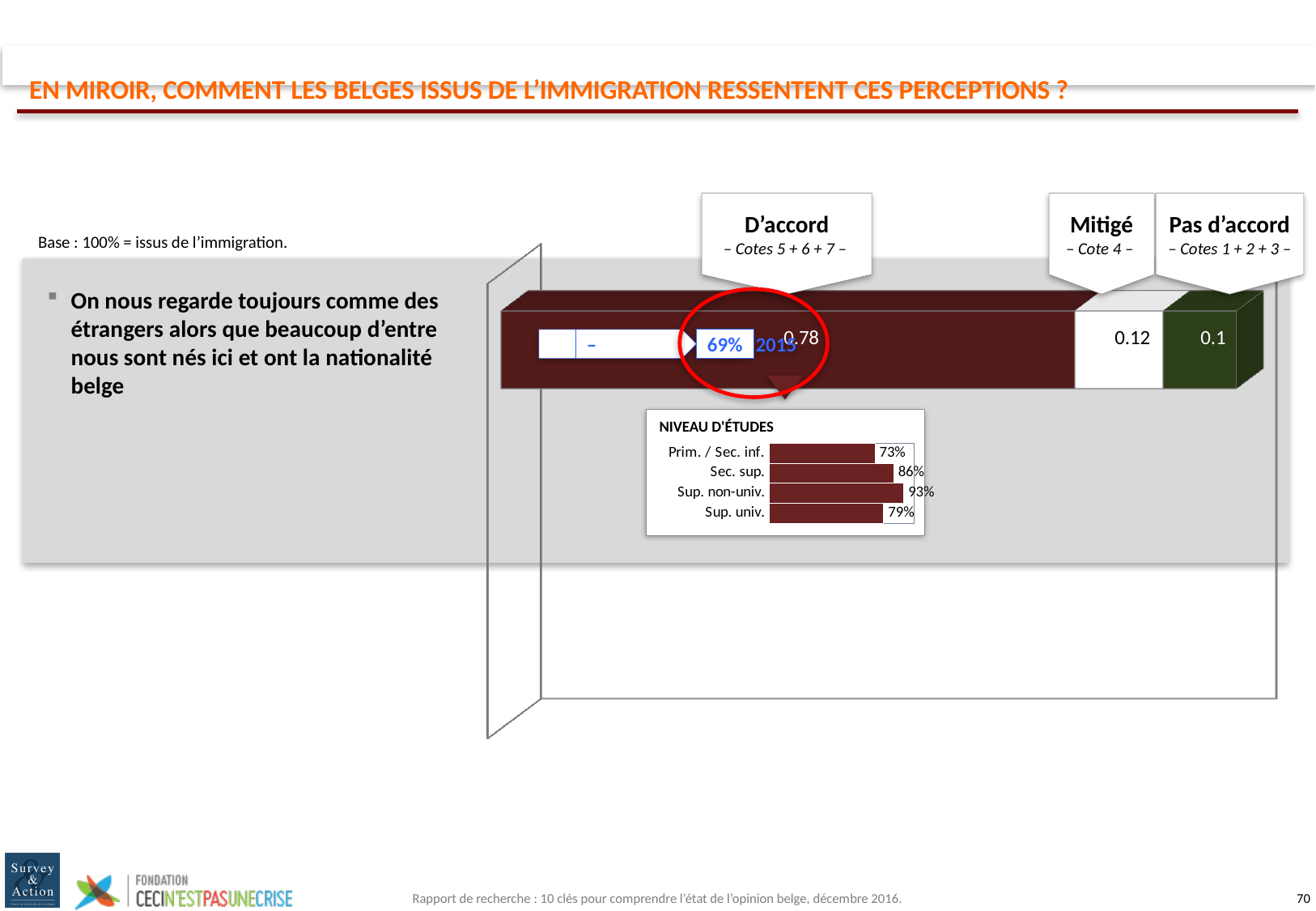
In the NIVEAU D'ÉTUDES chart, which is larger, Sec. sup. or Sup. univ.? Sec. sup. In the NIVEAU D'ÉTUDES chart, which education level has the highest value? Sup. non-univ. In the NIVEAU D'ÉTUDES chart, what is the value for Prim. / Sec. inf.? 73% What kind of chart is the NIVEAU D'ÉTUDES chart? Bar chart In the NIVEAU D'ÉTUDES chart, which education level has the lowest value? Prim. / Sec. inf. In the NIVEAU D'ÉTUDES chart, what is the value for Sup. non-univ.? 93% In the NIVEAU D'ÉTUDES chart, what is the value for Sup. univ.? 79% In the NIVEAU D'ÉTUDES chart, what is the difference between Sup. non-univ. and Sup. univ.? 14% In the main stacked bar, what is the value for D'accord? 0.78 How many education levels are shown in the NIVEAU D'ÉTUDES chart? 4 In the NIVEAU D'ÉTUDES chart, what is the value for Sec. sup.? 86% In the main stacked bar, what is the value for Mitigé? 0.12